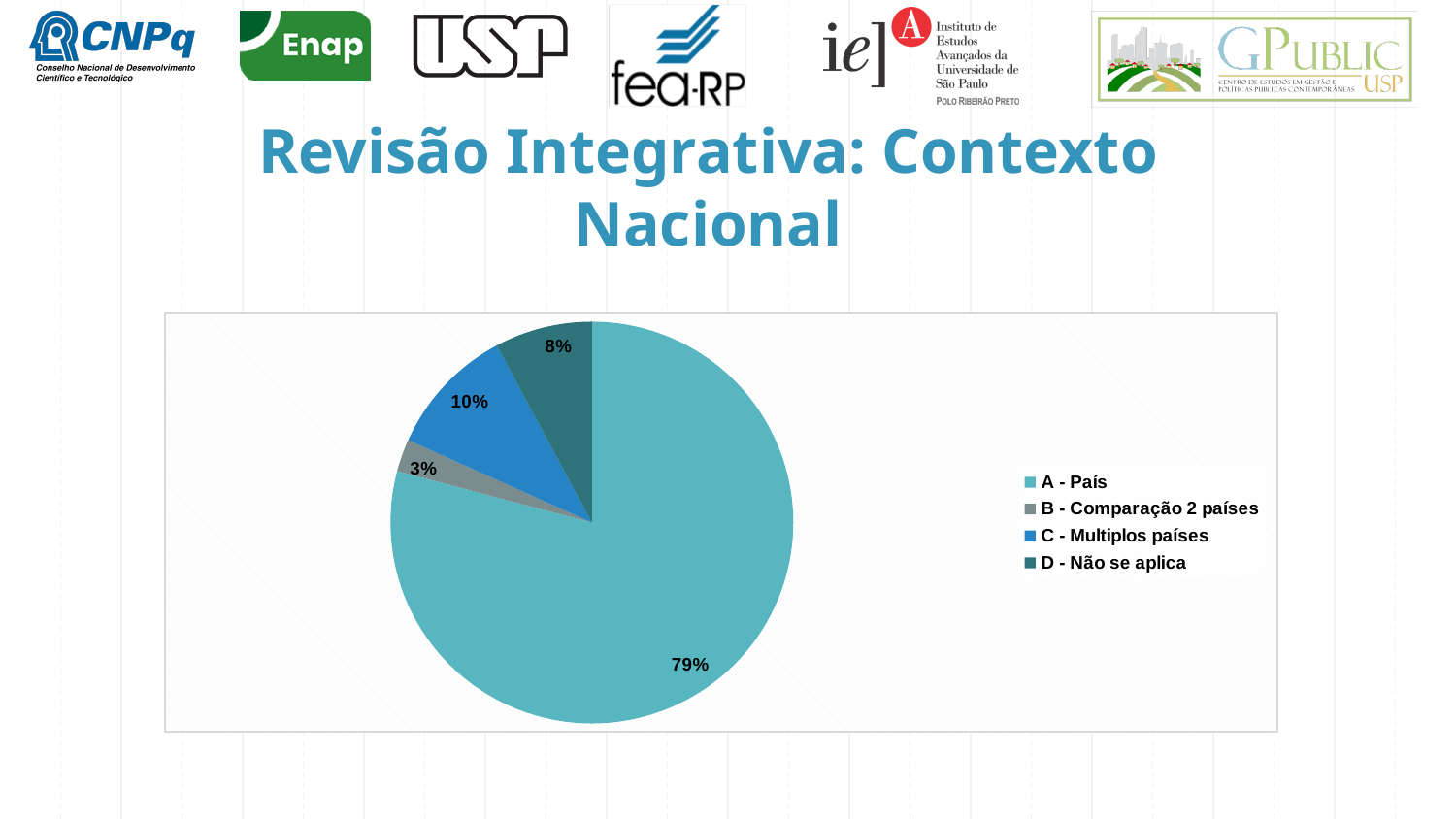
Which is larger, the slice for 'C - Multiplos países' or the slice for 'B - Comparação 2 países'? C - Multiplos países What is the difference in percentage points between 'C - Multiplos países' and 'D - Não se aplica'? 2 What kind of chart is shown on the slide? pie chart Which category has the smallest slice of the pie? B - Comparação 2 países How many categories does the pie chart have? 4 What is the difference in percentage points between 'A - País' and 'C - Multiplos países'? 69 What share of the pie does 'A - País' have? 79% What is the title of the slide containing the pie chart? Revisão Integrativa: Contexto Nacional Which category has the largest slice of the pie? A - País What share of the pie does 'D - Não se aplica' have? 8% What share of the pie does 'B - Comparação 2 países' have? 3%